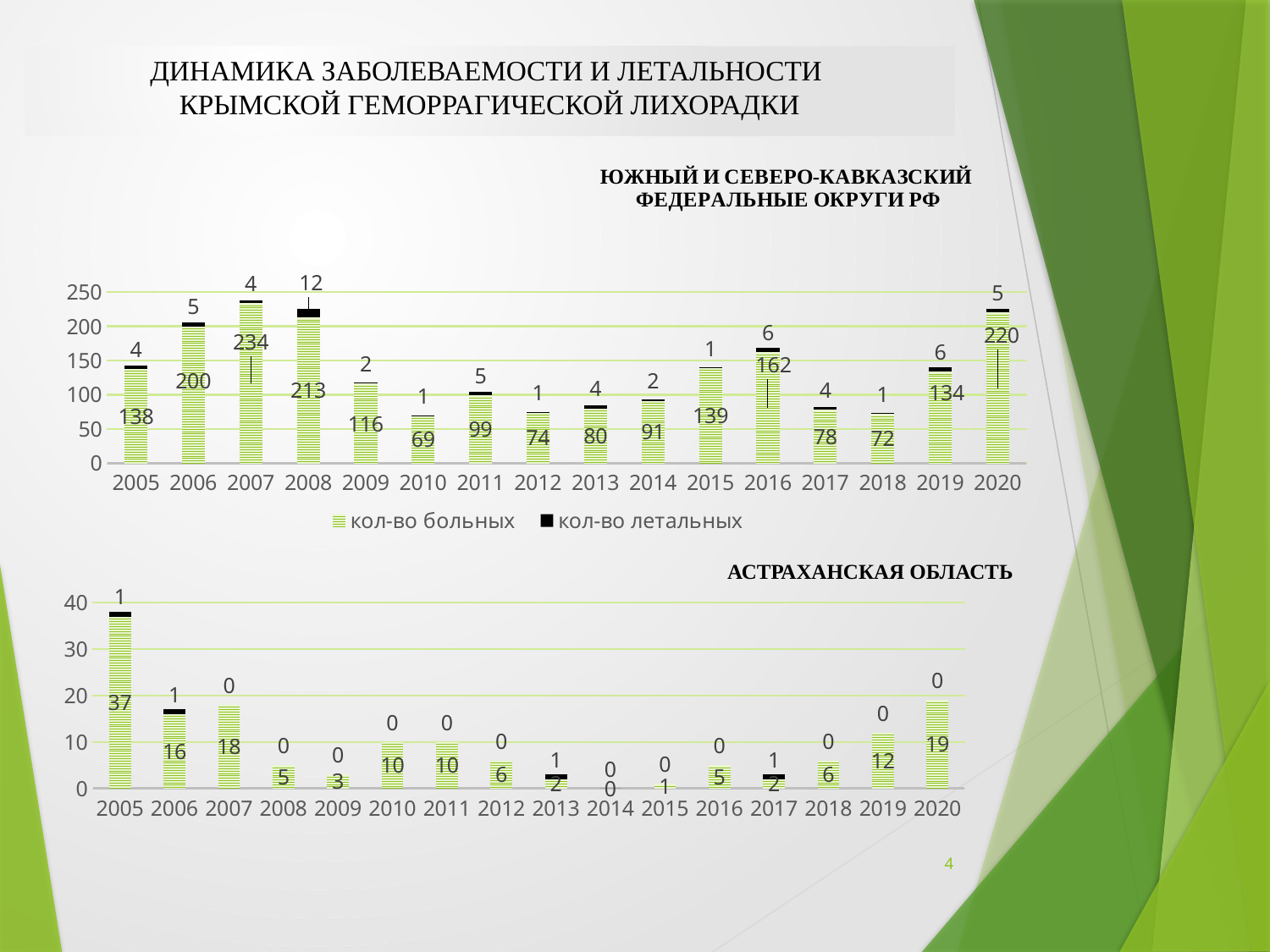
In the bottom chart (Астраханская область), what is the value of кол-во больных for 2005? 37 In the top chart (Южный и Северо-Кавказский федеральные округи РФ), what is the total of the stacked bar for 2016? 168 In the bottom chart (Астраханская область), which year has the highest кол-во больных? 2005 How many years are shown on the x axis of the bottom chart (Астраханская область)? 16 In the top chart (Южный и Северо-Кавказский федеральные округи РФ), what is the value of кол-во летальных for 2008? 12 In the bottom chart (Астраханская область), is кол-во больных larger in 2019 or in 2020? 2020 In the top chart (Южный и Северо-Кавказский федеральные округи РФ), which year has the highest кол-во летальных? 2008 In the top chart (Южный и Северо-Кавказский федеральные округи РФ), which year has the lowest кол-во больных? 2010 In the top chart (Южный и Северо-Кавказский федеральные округи РФ), what is the value of кол-во больных for 2007? 234 In the top chart (Южный и Северо-Кавказский федеральные округи РФ), what is the difference in кол-во больных between 2020 and 2019? 86 What type of chart is the bottom chart (Астраханская область)? Stacked bar chart How many series does the legend of the top chart list? 2